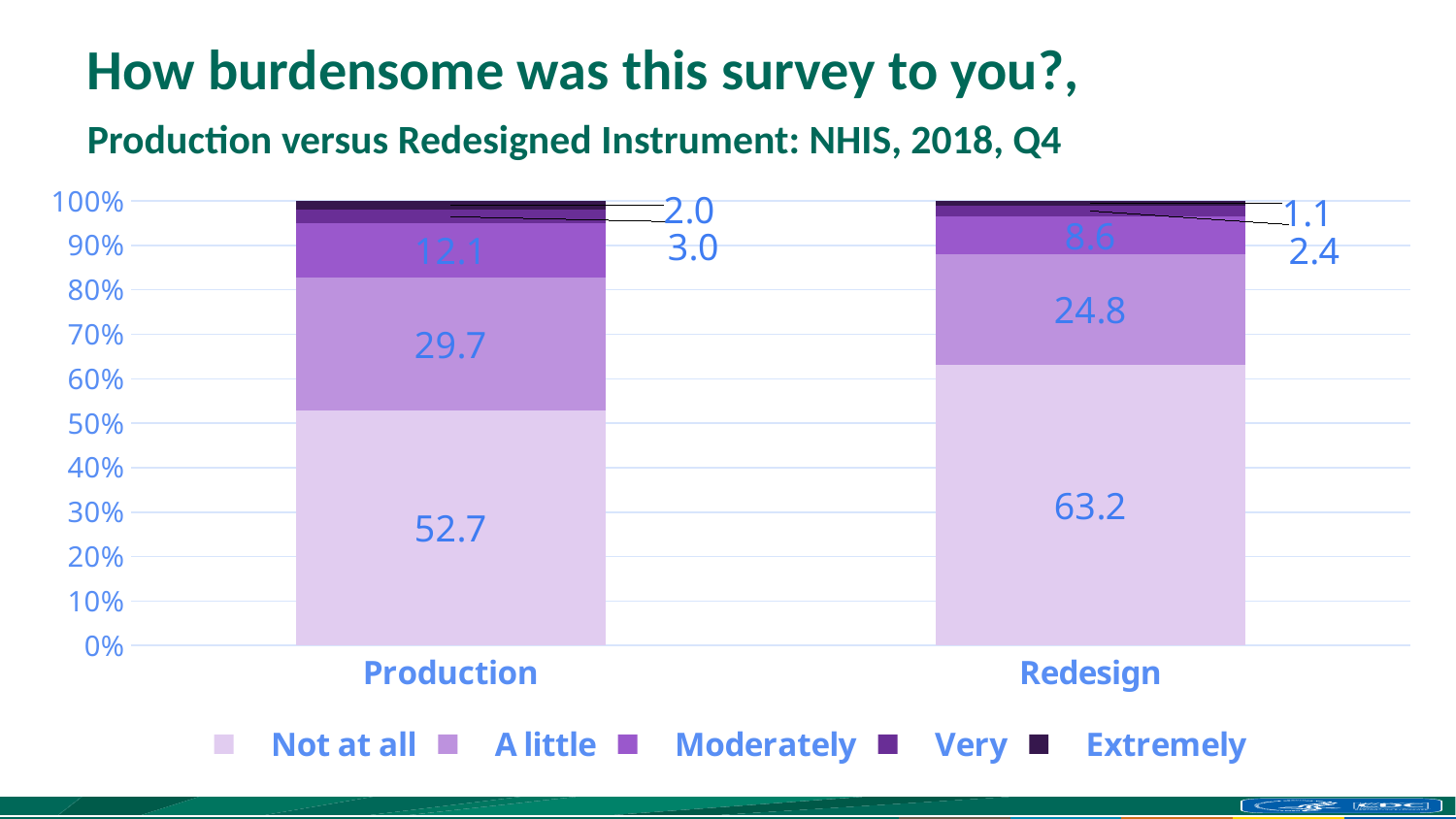
How many categories are shown on the x axis of the chart? 2 Which bar has the larger 'Not at all' value, Production or Redesign? Redesign What is the value for 'Not at all' in the Redesign bar? 63.2 What is the difference between the 'Not at all' values for Redesign and Production? 10.5 How many series does the legend list? 5 What is the value for 'Moderately' in the Production bar? 12.1 What kind of chart is shown on the slide? Stacked bar chart What is the difference between the 'A little' values for Production and Redesign? 4.9 What is the value for 'A little' in the Redesign bar? 24.8 What is the value for 'Moderately' in the Redesign bar? 8.6 What is the value for 'A little' in the Production bar? 29.7 What is the value for 'Not at all' in the Production bar? 52.7